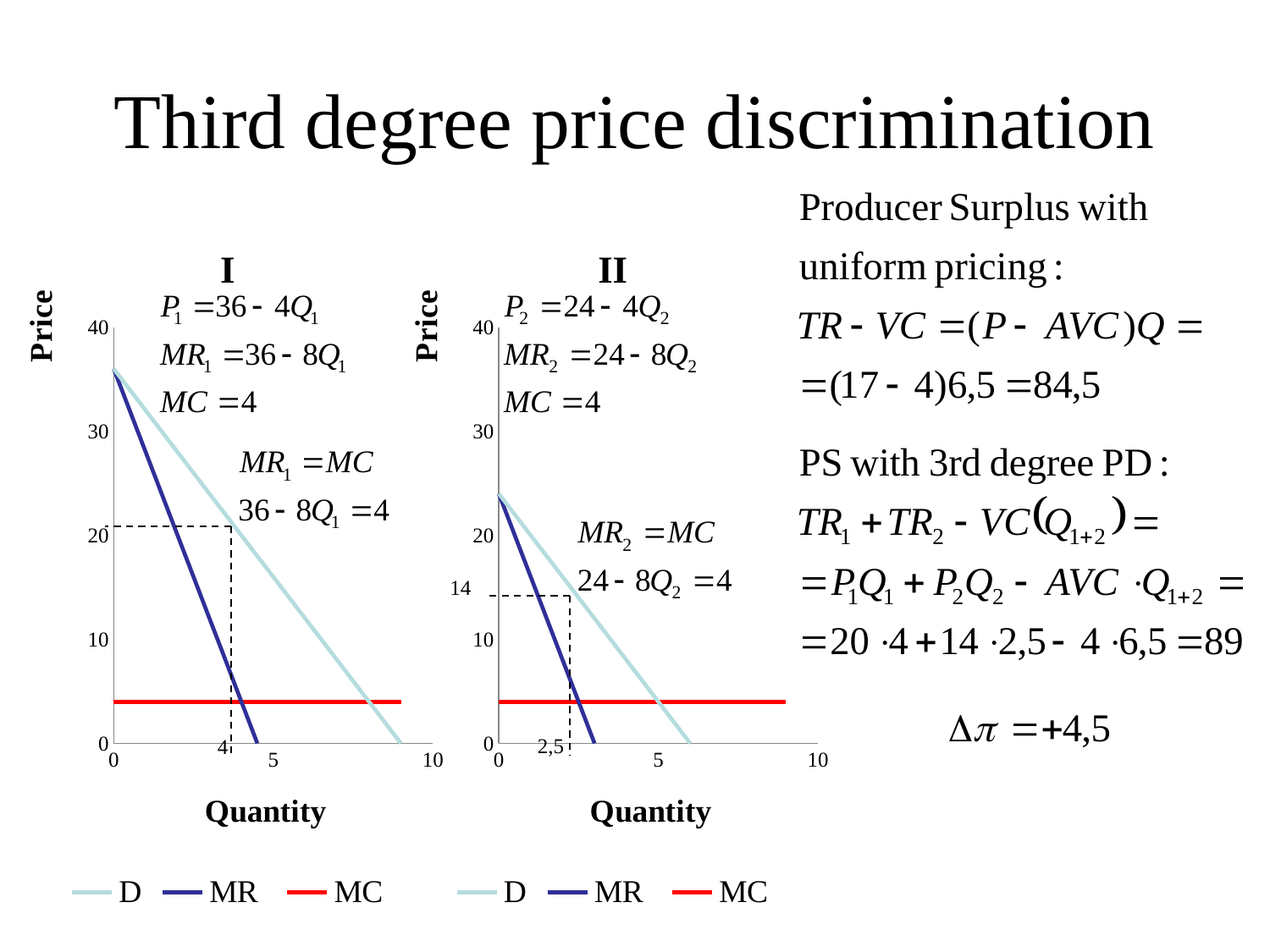
In chart I, is the price where the D line meets the vertical axis greater or less than 30? greater How many series does the legend list for chart II? 3 In chart I, at what quantity does the dashed line mark the point where MR meets MC? 4 What are the legend entries for chart I? D, MR, MC In chart I, what price does the dashed horizontal line mark on the vertical axis? 20 In chart I, does the D line rise or fall as quantity increases? fall What kind of chart is chart I? line chart In chart I, is the price level of the MC line greater or less than 10? less In chart II, at what quantity does the dashed vertical line meet the horizontal axis? 2,5 Which chart has the higher price intercept for the D line, chart I or chart II? chart I In chart II, is the price where the D line meets the vertical axis greater or less than 30? less In chart II, what price does the dashed horizontal line mark on the vertical axis? 14